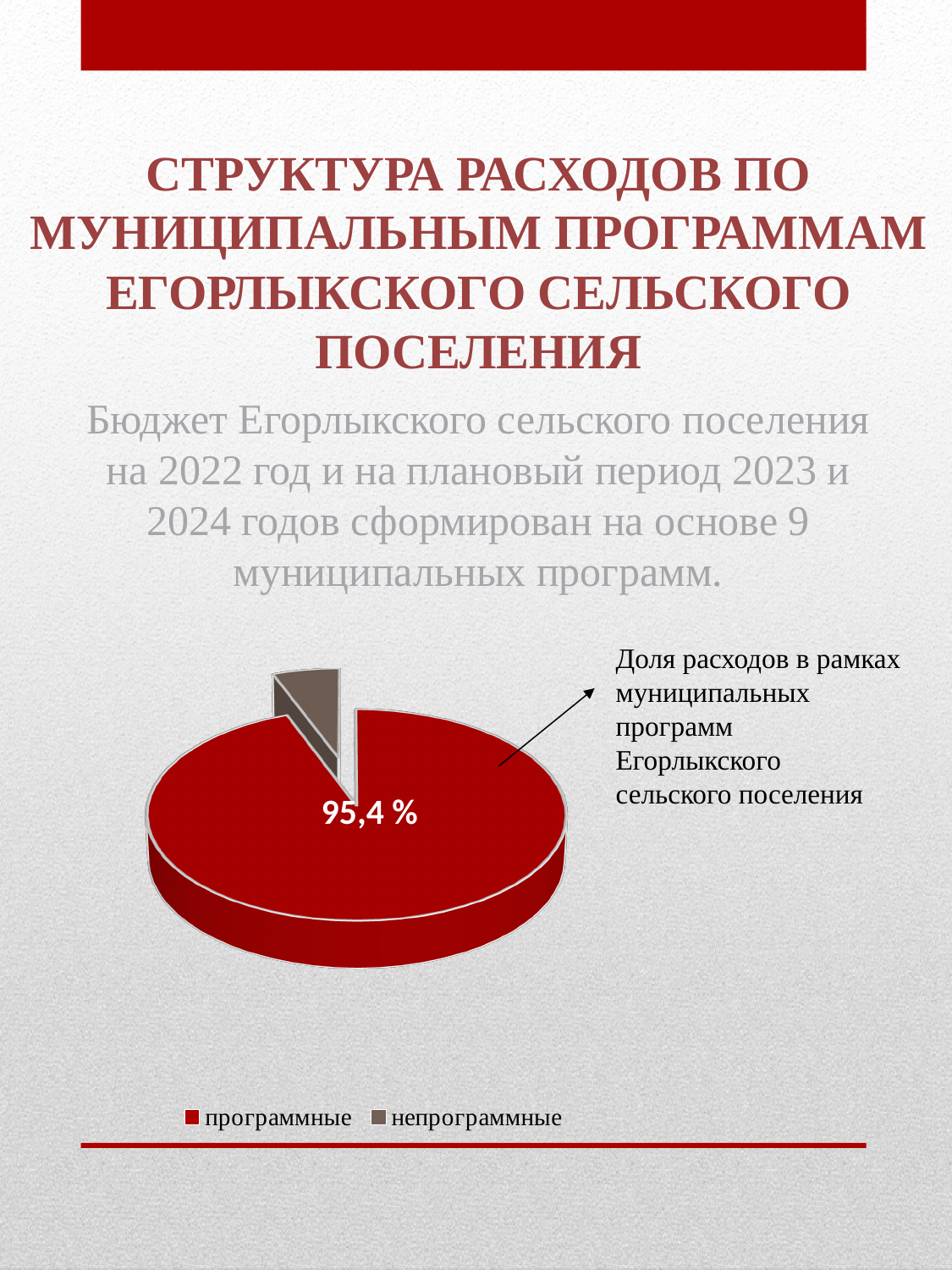
Which slice of the pie chart is the largest? программные How many slices does the pie chart have? 2 What kind of chart is shown on the slide? pie chart What share of the pie is labelled for the 'программные' slice? 95,4 % What are the two legend entries of the pie chart? программные, непрограммные Which is larger in the pie chart, 'программные' or 'непрограммные'? программные Which slice of the pie chart is the smallest? непрограммные How many entries does the legend of the pie chart list? 2 What colour is the 'программные' slice in the pie chart? red What value is printed on the 'программные' slice of the pie chart? 95,4 %